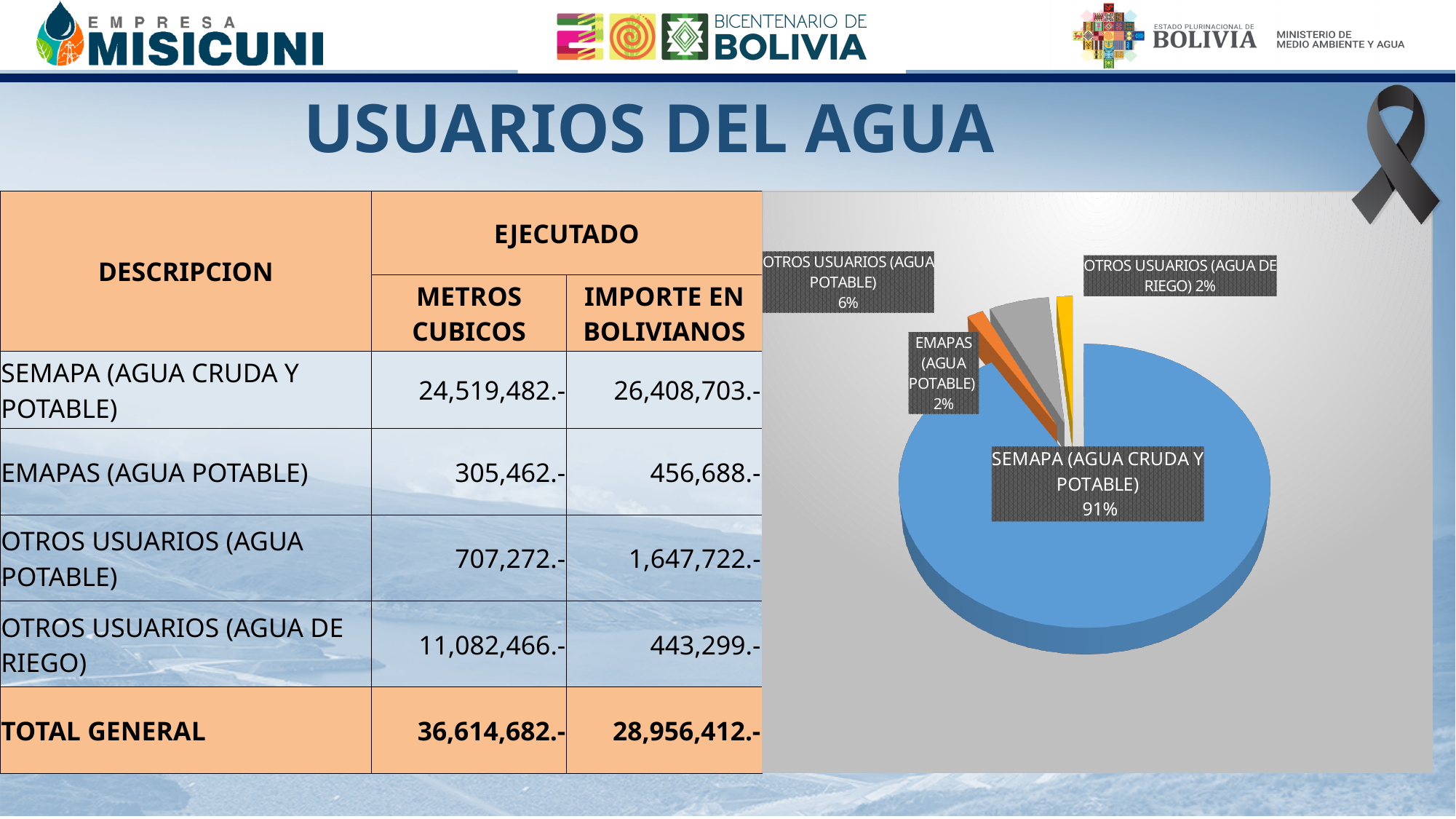
In the pie chart, what share does OTROS USUARIOS (AGUA POTABLE) have? 6% Which slice of the pie chart is the largest? SEMAPA (AGUA CRUDA Y POTABLE) In the pie chart, which is larger: the share of OTROS USUARIOS (AGUA POTABLE) or the share of EMAPAS (AGUA POTABLE)? OTROS USUARIOS (AGUA POTABLE) How many slices does the pie chart have? 4 In the pie chart, what share does SEMAPA (AGUA CRUDA Y POTABLE) have? 91% In the pie chart, what is the difference in percentage points between the SEMAPA (AGUA CRUDA Y POTABLE) share and the OTROS USUARIOS (AGUA POTABLE) share? 85% In the pie chart, what share does EMAPAS (AGUA POTABLE) have? 2% What kind of chart is shown on the right side of the slide? pie chart What colour is the EMAPAS (AGUA POTABLE) slice in the pie chart? orange In the pie chart, what is the difference in percentage points between the OTROS USUARIOS (AGUA POTABLE) share and the EMAPAS (AGUA POTABLE) share? 4% What colour is the SEMAPA (AGUA CRUDA Y POTABLE) slice in the pie chart? blue